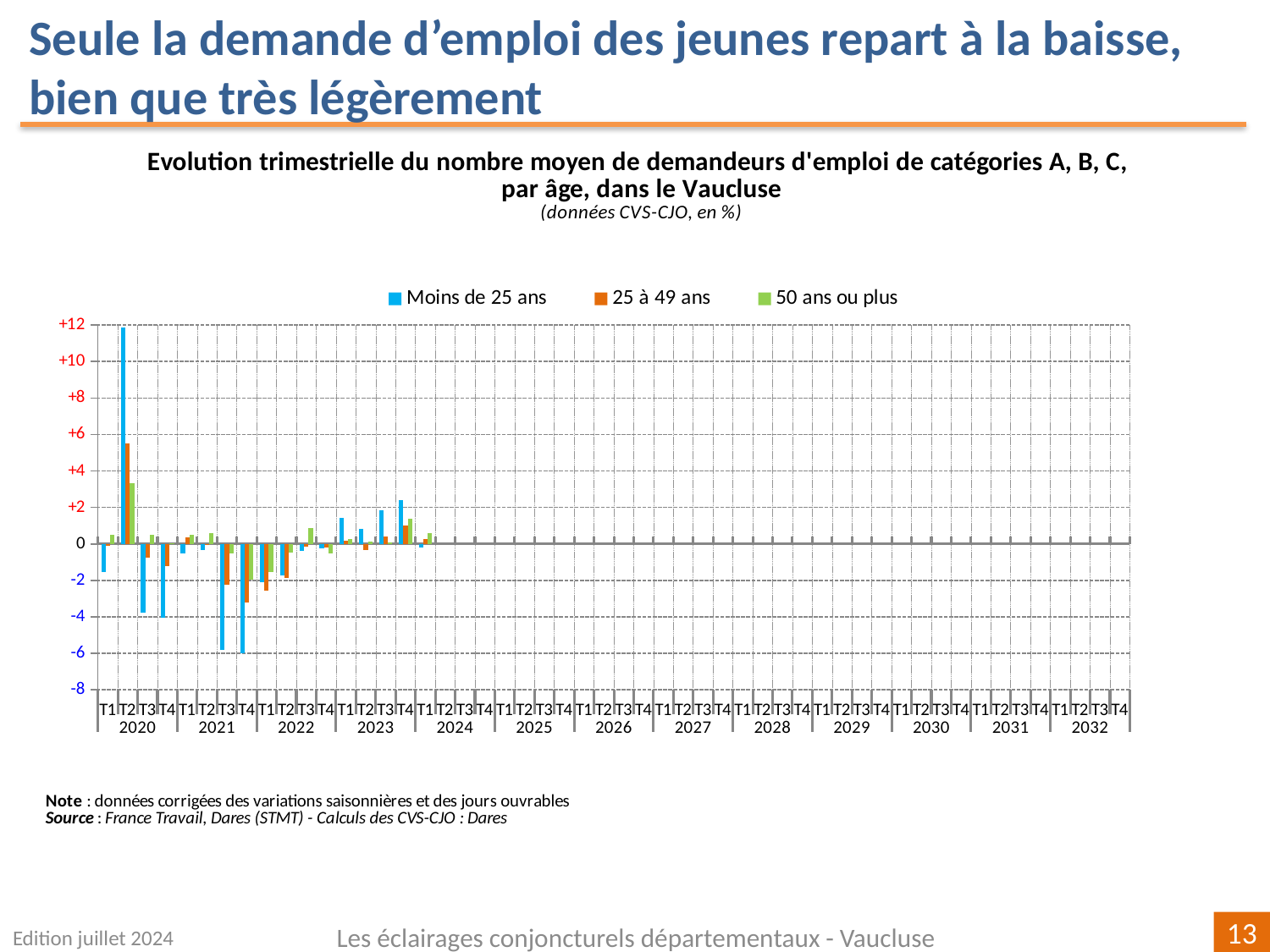
In which quarter does the 'Moins de 25 ans' series reach its highest value? T2 2020 In T2 2020, which series has the larger value: 'Moins de 25 ans' or '25 à 49 ans'? Moins de 25 ans Is the value for 'Moins de 25 ans' in T2 2020 greater or less than +10? greater Which series is shown in blue in the legend? Moins de 25 ans In T4 2021, which series has the lowest value? Moins de 25 ans Is the value for '50 ans ou plus' in T2 2020 greater or less than +2? greater How many series does the legend list? 3 Which series is shown in orange in the legend? 25 à 49 ans How many years are labelled along the x axis? 13 What kind of chart is shown on the slide? bar chart Is the value for '25 à 49 ans' in T2 2020 greater or less than +4? greater